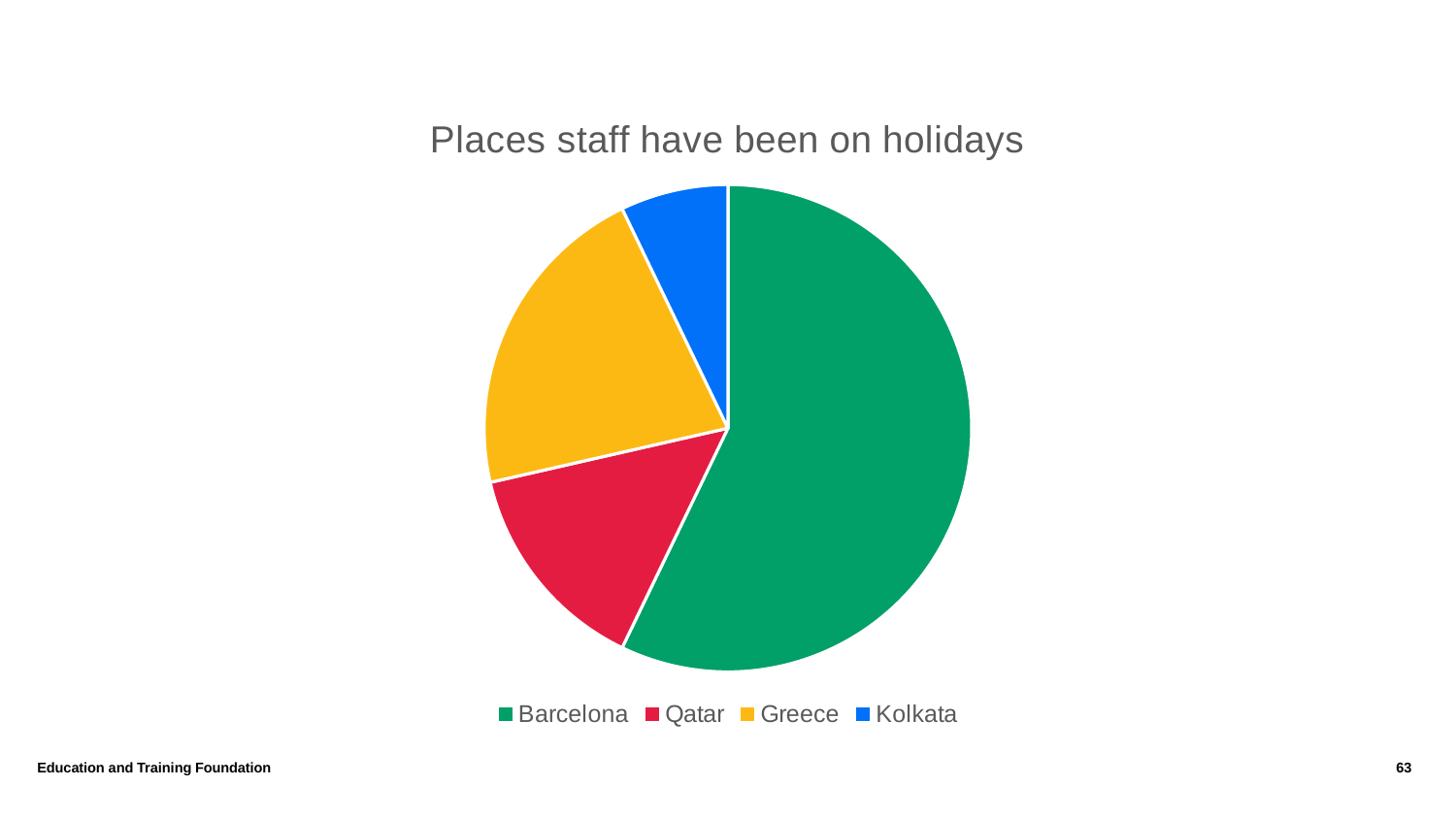
Which colour represents Qatar in the pie chart? red How many categories (slices) does the pie chart have? 4 What is the title of the chart? Places staff have been on holidays Which slice is larger, Greece or Qatar? Greece Which slice is larger, Greece or Kolkata? Greece What kind of chart is shown on the slide? pie chart Which slice is larger, Barcelona or Qatar? Barcelona Does the Barcelona slice take up more or less than half of the pie? more Which place has the largest slice of the pie? Barcelona How many entries does the legend list? 4 Which place has the smallest slice of the pie? Kolkata